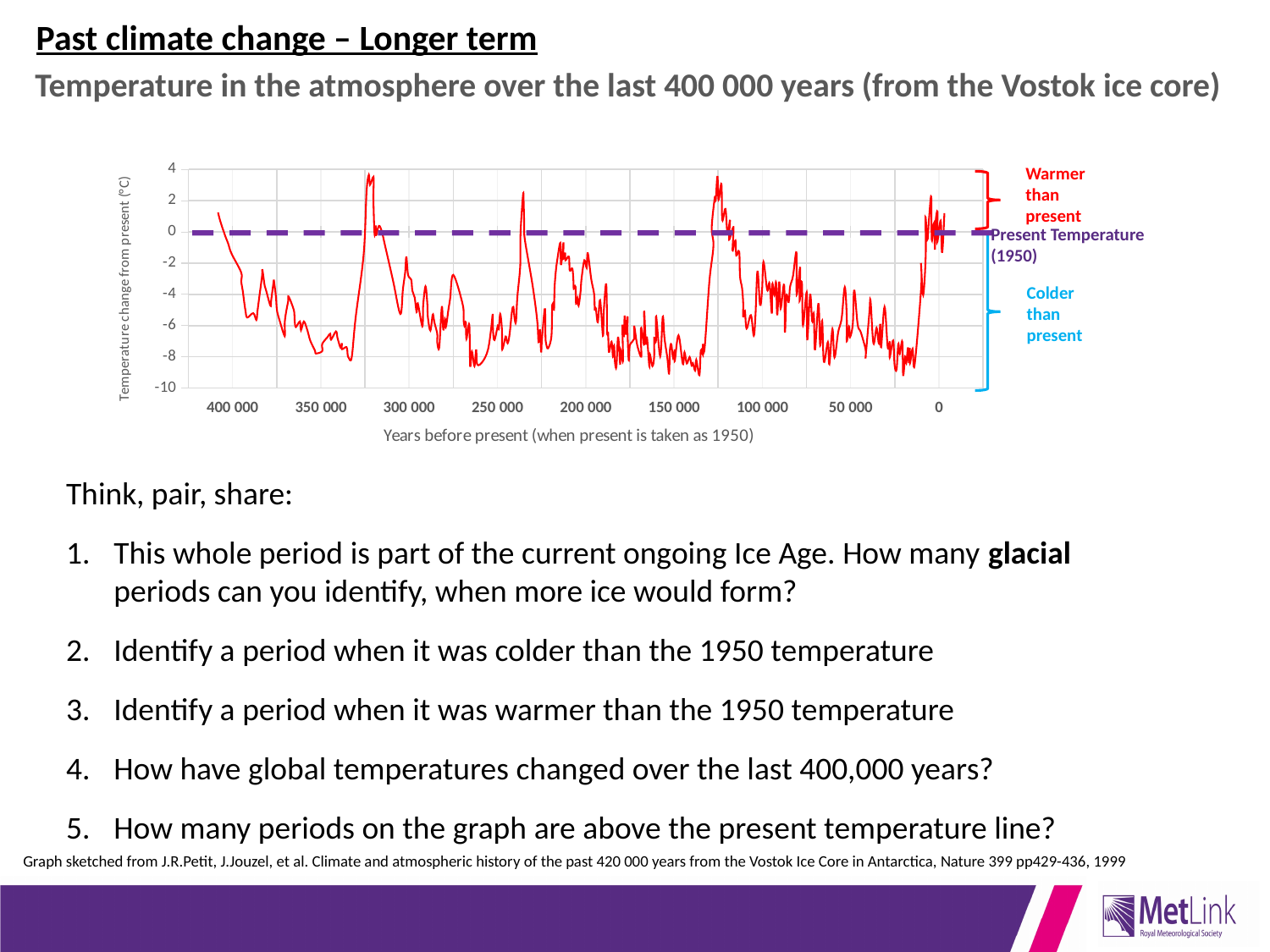
What is the label of the vertical axis of the chart? Temperature change from present (°C) What kind of chart is shown on the slide? line chart Is the temperature change at 100 000 years before present greater or less than 0? less Is the temperature change at 250 000 years before present greater or less than -4? less What does the dashed purple horizontal line on the chart represent? Present Temperature (1950) Is the temperature change at 350 000 years before present greater or less than -2? less